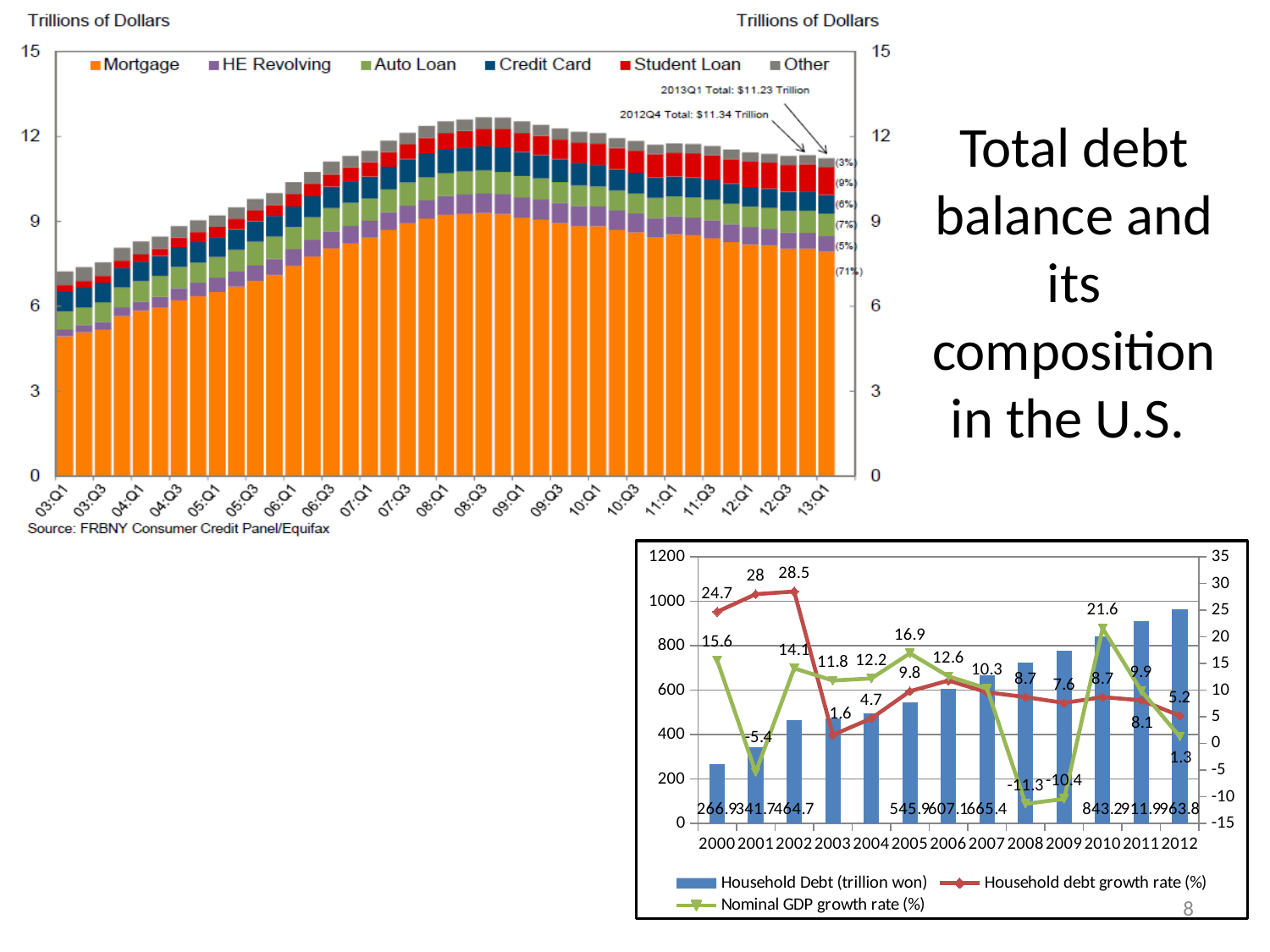
What kind of chart is the top-left chart? Stacked bar chart In the top-left chart, what was the total debt balance in 2013Q1? $11.23 Trillion In the bottom-right chart, what is the Household Debt (trillion won) value for 2012? 963.8 In the top-left chart, what share of the 2013Q1 total is Mortgage? 71% In the bottom-right chart, how many series does the legend list? 3 In the bottom-right chart, which year has the highest Household debt growth rate (%)? 2002 In the top-left chart, how many series does the legend list? 6 In the top-left chart, which total is larger, 2012Q4 or 2013Q1? 2012Q4 In the bottom-right chart, what is the difference in Household Debt (trillion won) between 2012 and 2000? 696.9 In the bottom-right chart, how many years are shown on the x axis? 13 In the top-left chart, what was the total debt balance in 2012Q4? $11.34 Trillion In the bottom-right chart, what is the Nominal GDP growth rate (%) for 2010? 21.6